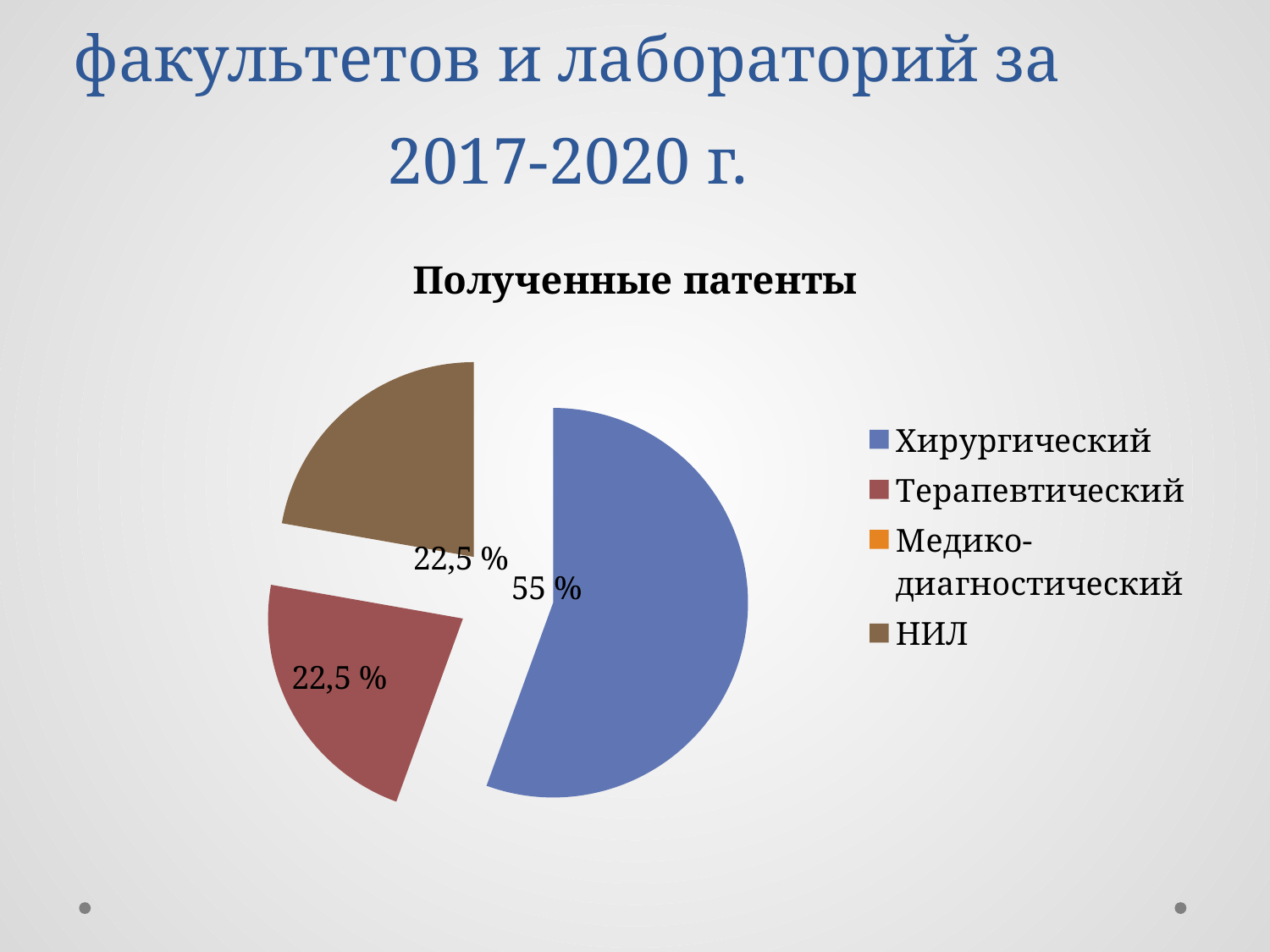
What share of the pie does Терапевтический have? 22,5 % What is the title of the chart? Полученные патенты Is the share for Хирургический greater or less than 50%? greater Which category has the largest slice of the pie? Хирургический How many slices with data labels are visible in the pie? 3 What share of the pie does Хирургический have? 55 % What kind of chart is shown on the slide? pie chart What is the difference between the share for Хирургический and the share for НИЛ? 32,5 % What share of the pie does НИЛ have? 22,5 % Which is larger, the slice for Хирургический or the slice for Терапевтический? Хирургический How many entries does the chart legend list? 4 What colour is the slice for Хирургический? blue